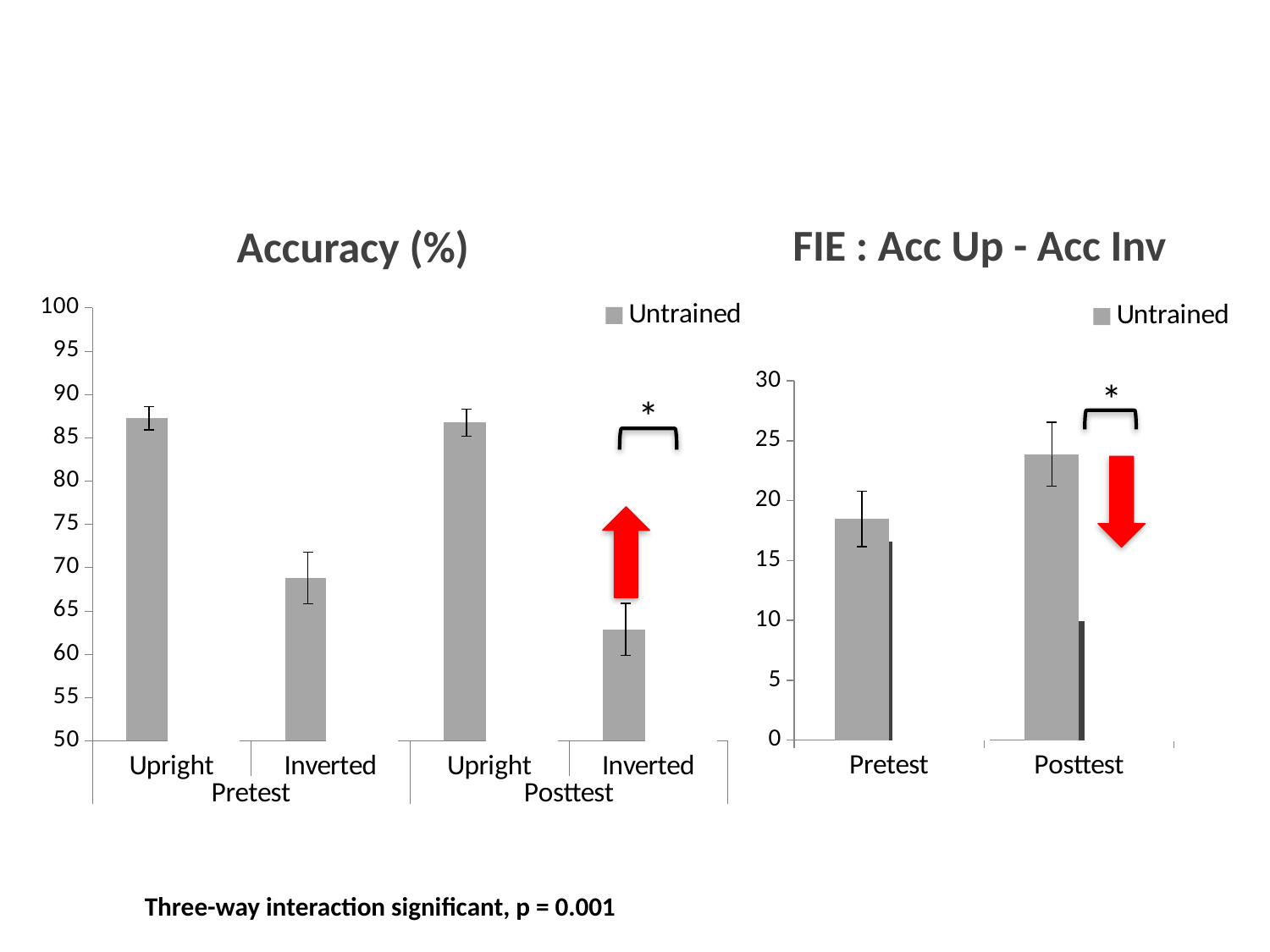
In the Accuracy (%) chart, is the value for Upright in the Pretest group greater or less than 85? greater In the Accuracy (%) chart, is the value for Inverted in the Pretest group greater or less than 65? greater In the FIE : Acc Up - Acc Inv chart, is the value for Pretest greater or less than 20? less In the Accuracy (%) chart, which bar has the lowest value? Posttest Inverted In the Accuracy (%) chart, which is larger: Inverted in the Pretest group or Inverted in the Posttest group? Inverted in the Pretest group What kind of chart is the Accuracy (%) chart? Bar chart In the FIE : Acc Up - Acc Inv chart, which category has the higher value, Pretest or Posttest? Posttest How many categories are shown on the x axis of the FIE : Acc Up - Acc Inv chart? 2 What series name does the legend of the FIE : Acc Up - Acc Inv chart list? Untrained How many bars are plotted in the Accuracy (%) chart? 4